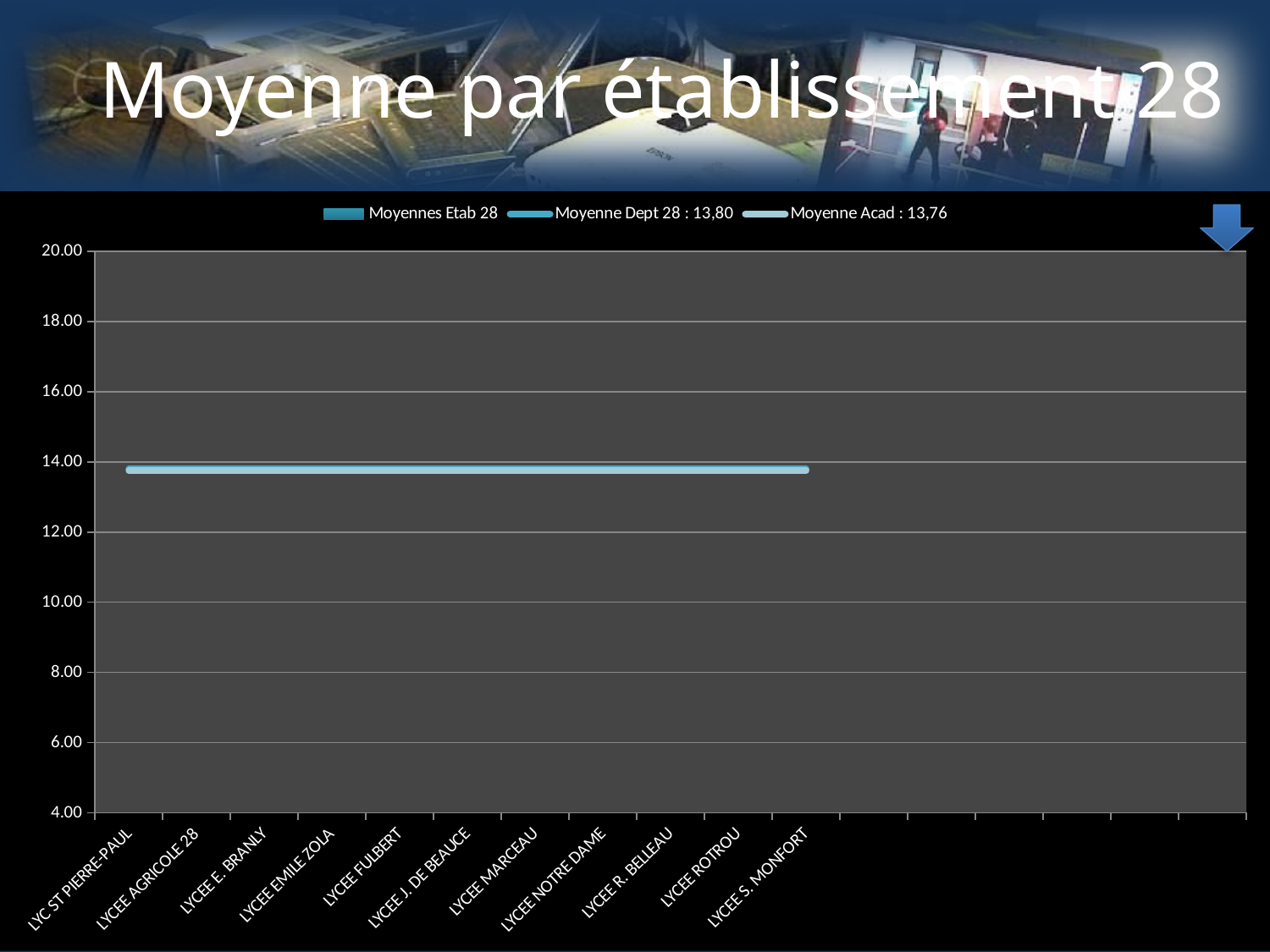
Does the Moyenne Dept 28 line rise, fall or stay flat across the establishments? stays flat What value does the legend give for Moyenne Acad? 13,76 What is the name of the first series in the legend? Moyennes Etab 28 What value does the legend give for Moyenne Dept 28? 13,80 What is the difference between Moyenne Dept 28 and Moyenne Acad? 0,04 Is the Moyenne Dept 28 line greater or less than 14.00? less What is the title of the slide? Moyenne par établissement 28 How many establishments are listed along the x axis? 11 What is the first establishment listed on the x axis? LYC ST PIERRE-PAUL Which is larger, Moyenne Dept 28 or Moyenne Acad? Moyenne Dept 28 Is the Moyenne Acad line greater or less than 12.00? greater How many series does the legend list? 3